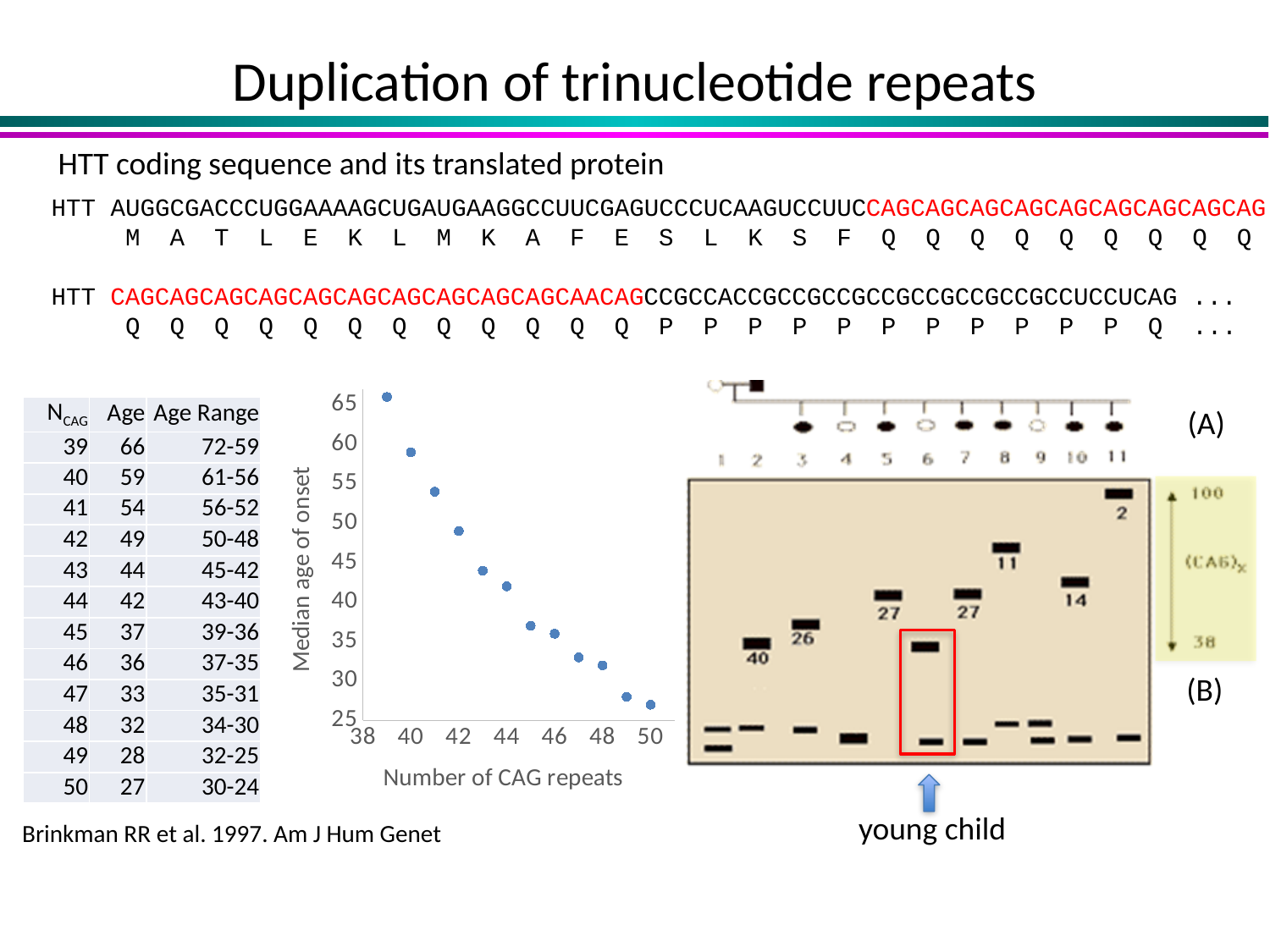
In the scatter chart, which has a higher median age of onset: 42 CAG repeats or 46 CAG repeats? 42 CAG repeats In the scatter chart, which number of CAG repeats has the highest median age of onset? 39 In the scatter chart, does the median age of onset rise or fall as the number of CAG repeats increases? fall In the scatter chart, what is the label of the y axis? Median age of onset In the scatter chart, what is the label of the x axis? Number of CAG repeats In the scatter chart, is the median age of onset for 50 CAG repeats greater or less than 30? less According to the table beside the scatter chart, what is the median age of onset for 45 CAG repeats? 37 In the scatter chart, which number of CAG repeats has the lowest median age of onset? 50 In the scatter chart, is the median age of onset for 39 CAG repeats greater or less than 65? greater How many data points are plotted in the scatter chart? 12 In the scatter chart, is the median age of onset for 44 CAG repeats greater or less than 40? greater What kind of chart is the plot of median age of onset against number of CAG repeats? scatter chart